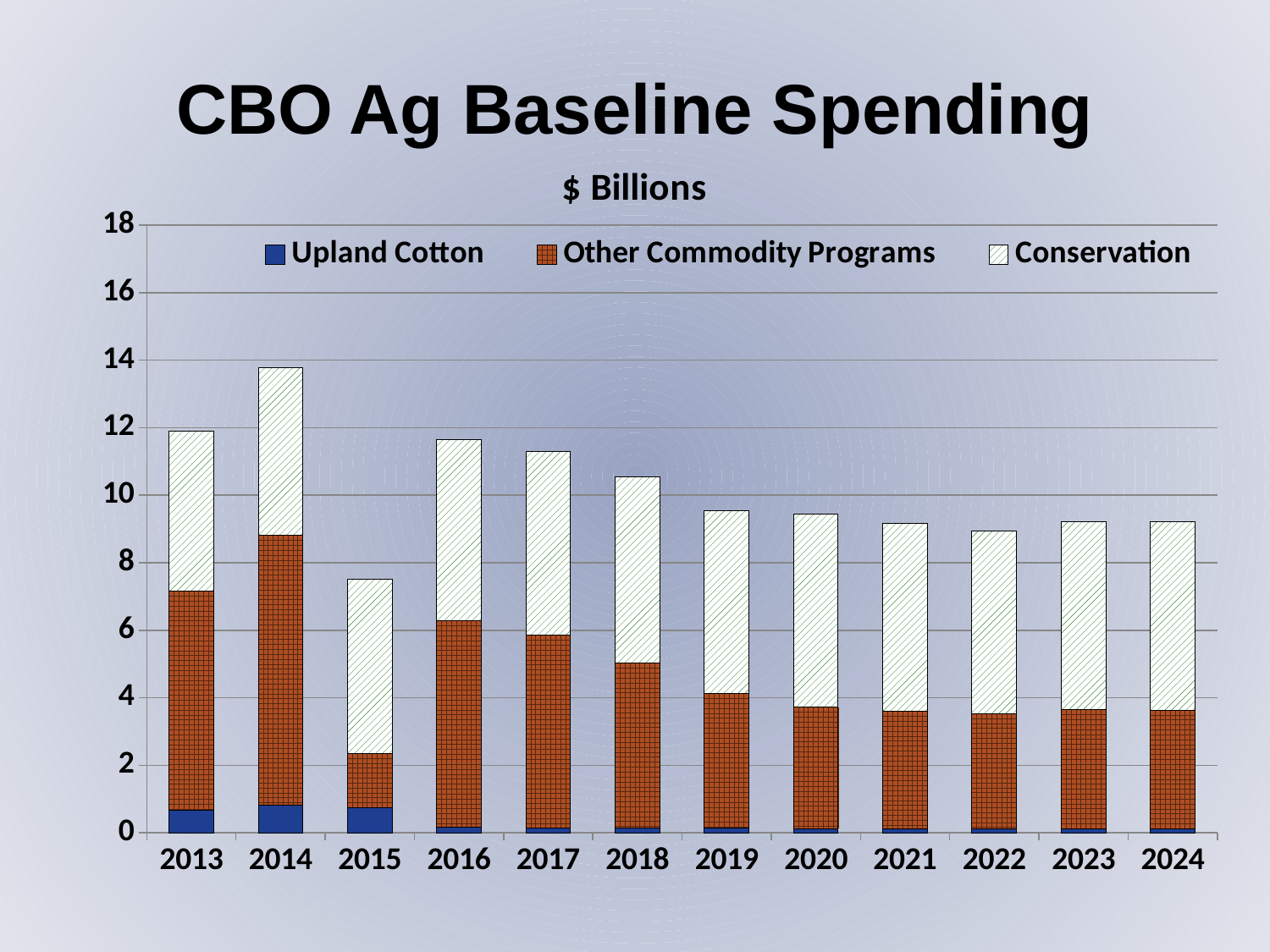
Do the total bars generally rise or fall from 2016 to 2022? fall Is the total bar for 2014 greater or less than 12? greater Which year has the taller total bar, 2013 or 2018? 2013 How many series does the chart's legend list? 3 What kind of chart is shown on the slide? Stacked bar chart What is the title of the slide's chart? $ Billions How many years are shown along the x axis of the chart? 12 What unit is shown above the chart? $ Billions Is the total bar for 2015 greater or less than 8? less Which year has the tallest total bar? 2014 Is the total bar for 2024 greater or less than 10? less Which year has the shortest total bar? 2015